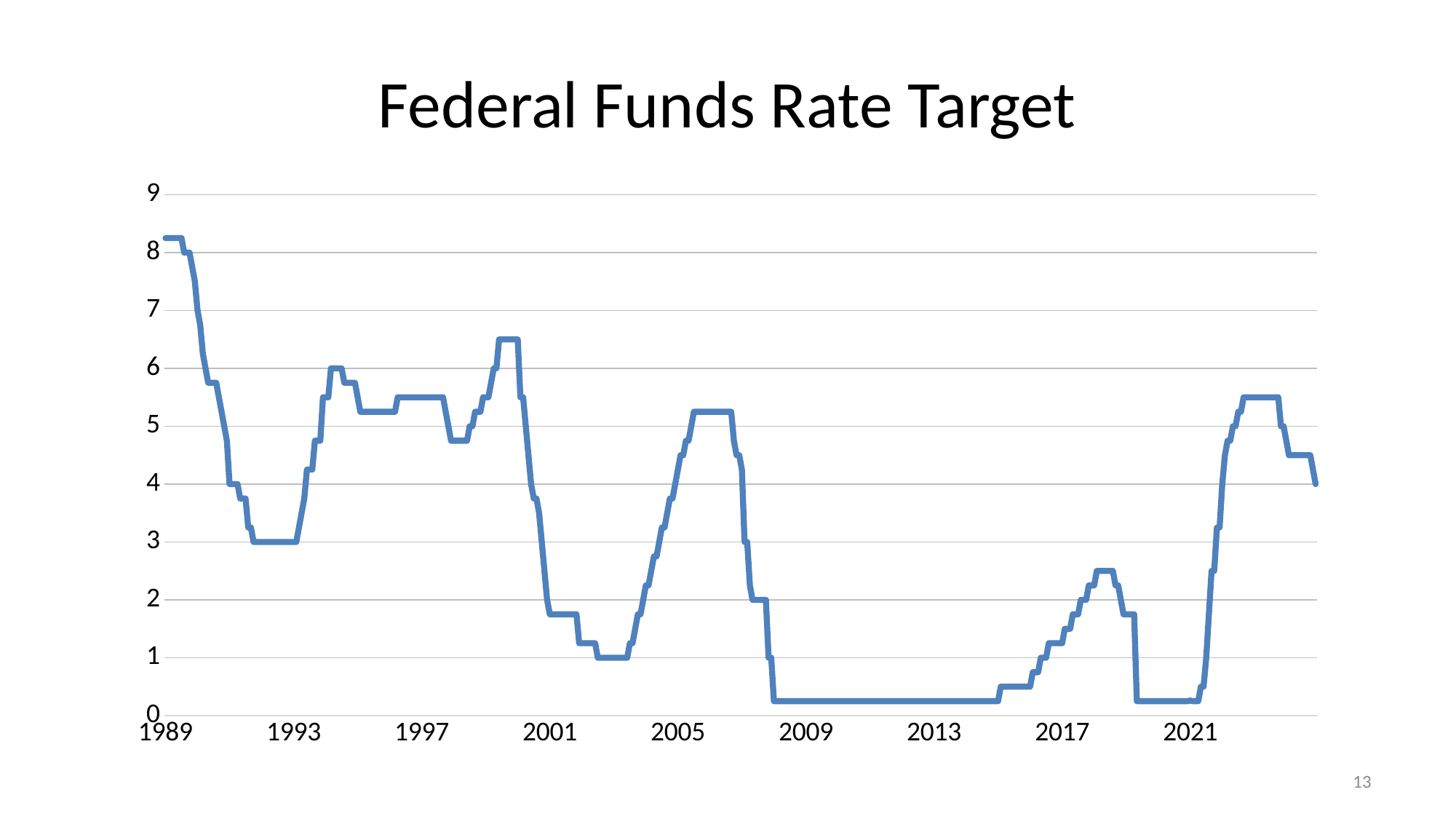
Is the value in 2013 greater or less than 1? less Is the peak value reached around 2000 greater or less than 6? greater Is the value in 2017 greater or less than 2? less In which year labelled on the x axis does the line reach its highest value? 1989 What is the title of the chart? Federal Funds Rate Target Does the line rise or fall between 2021 and 2023? rise Does the line rise or fall between 1989 and 1993? fall What kind of chart is shown on the slide? line chart